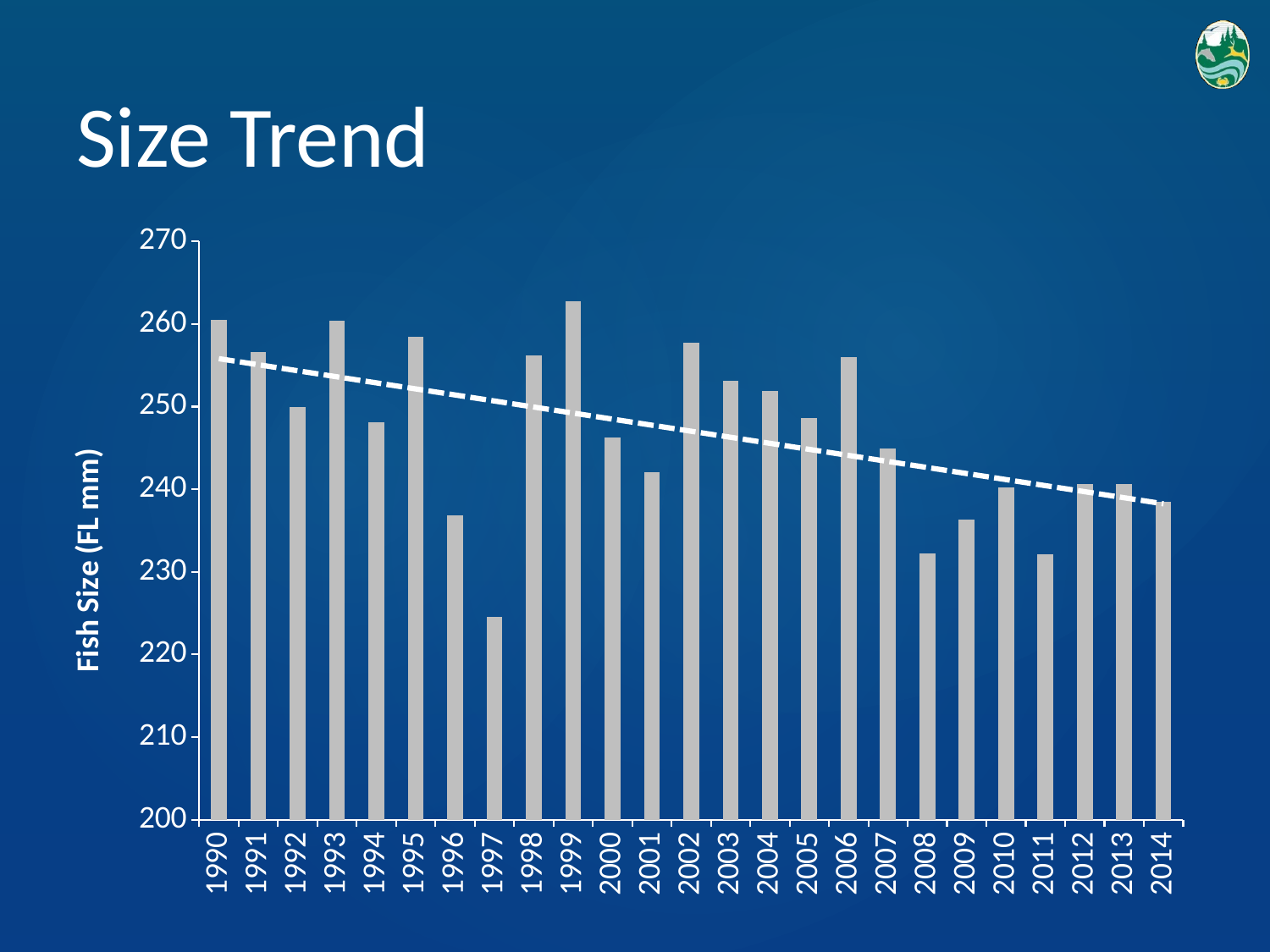
Which year has the highest fish size? 1999 Is the value for 1999 greater or less than 260? greater How many years (bars) are plotted on the chart? 25 Is the value for 2006 greater or less than 250? greater What kind of chart is shown on the slide? bar chart What is the label on the vertical axis of the chart? Fish Size (FL mm) Is the value for 1996 greater or less than 240? less Which year has the larger fish size, 1990 or 2014? 1990 Which year has the lowest fish size? 1997 According to the dashed trend line, do fish sizes rise or fall from 1990 to 2014? fall Which year has the larger fish size, 1992 or 2011? 1992